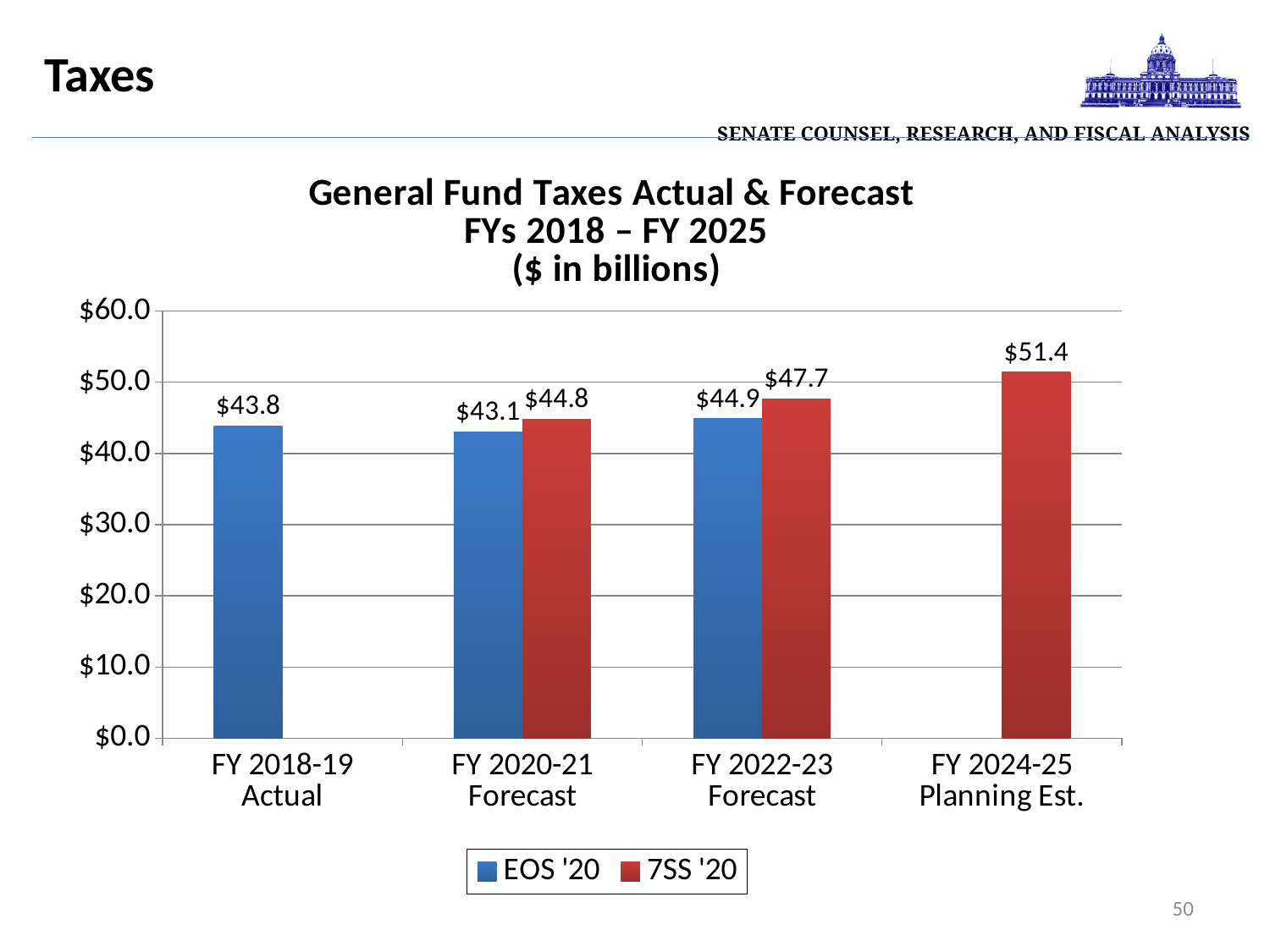
For FY 2020-21 Forecast, which series has the larger value, EOS '20 or 7SS '20? 7SS '20 Is the 7SS '20 value for FY 2024-25 Planning Est. greater or less than $50.0? greater How many categories are shown on the x axis? 4 How many series does the legend list? 2 Which category has the highest 7SS '20 value? FY 2024-25 Planning Est. What kind of chart is shown on the slide? Bar chart Which category has the lowest EOS '20 value? FY 2020-21 Forecast What is the difference between the 7SS '20 and EOS '20 values for FY 2022-23 Forecast? $2.8 What is the EOS '20 value for FY 2018-19 Actual? $43.8 What is the 7SS '20 value for FY 2024-25 Planning Est.? $51.4 What is the EOS '20 value for FY 2020-21 Forecast? $43.1 What is the 7SS '20 value for FY 2022-23 Forecast? $47.7